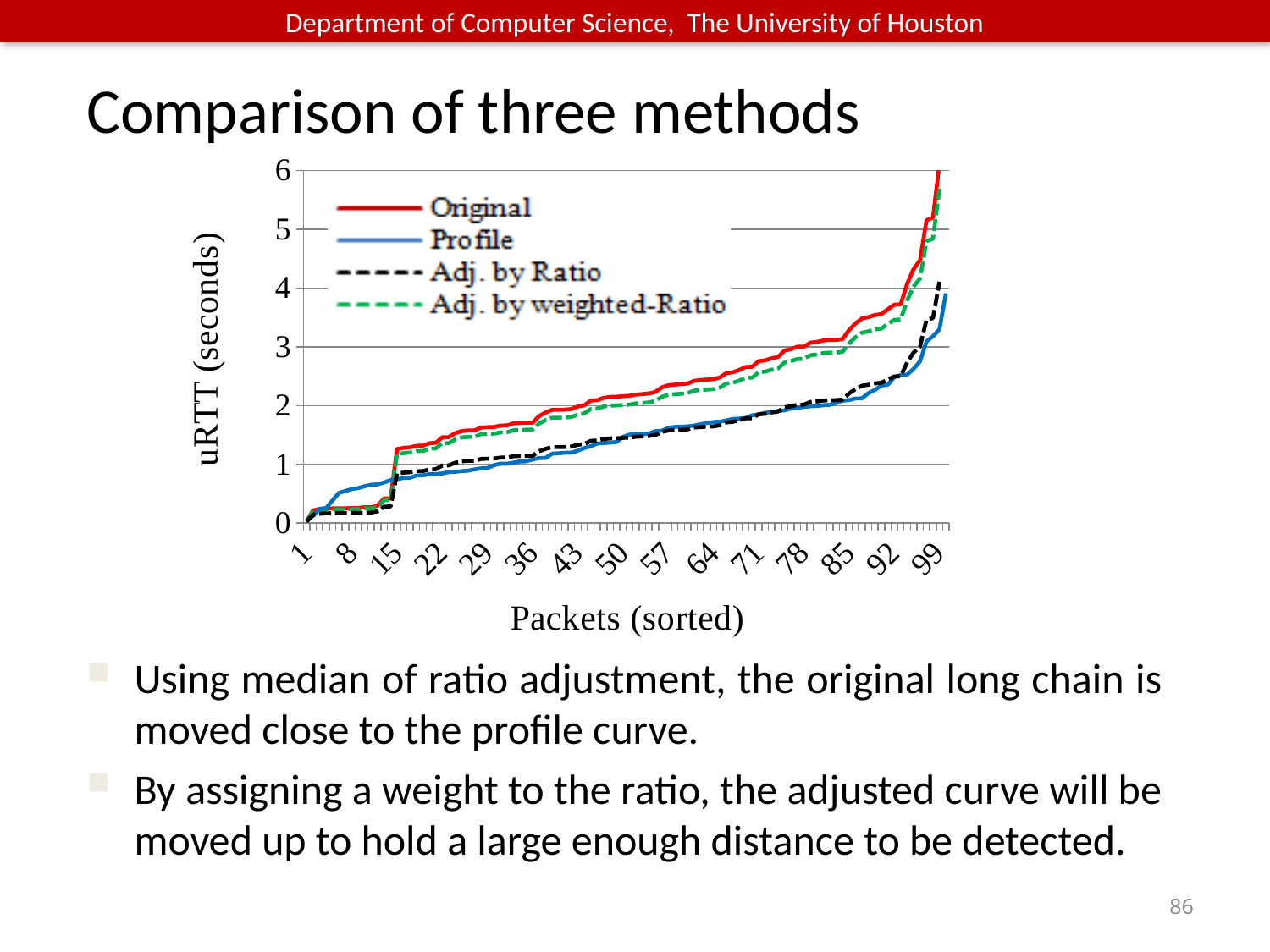
At packet 36, which series has the higher value, Adj. by weighted-Ratio or Adj. by Ratio? Adj. by weighted-Ratio What is the label of the y axis? uRTT (seconds) Is the value for Original at packet 64 greater or less than 2? greater Is the value for Profile at packet 71 greater or less than 3? less Is the value for Profile at packet 8 greater or less than 1? less Which series reaches the highest value at the right end of the chart? Original What kind of chart is shown on the slide? line chart Do the values of the Original series rise or fall along the x axis? rise What is the label of the x axis? Packets (sorted) How many series does the legend list? 4 At packet 92, which series has the higher value, Original or Profile? Original